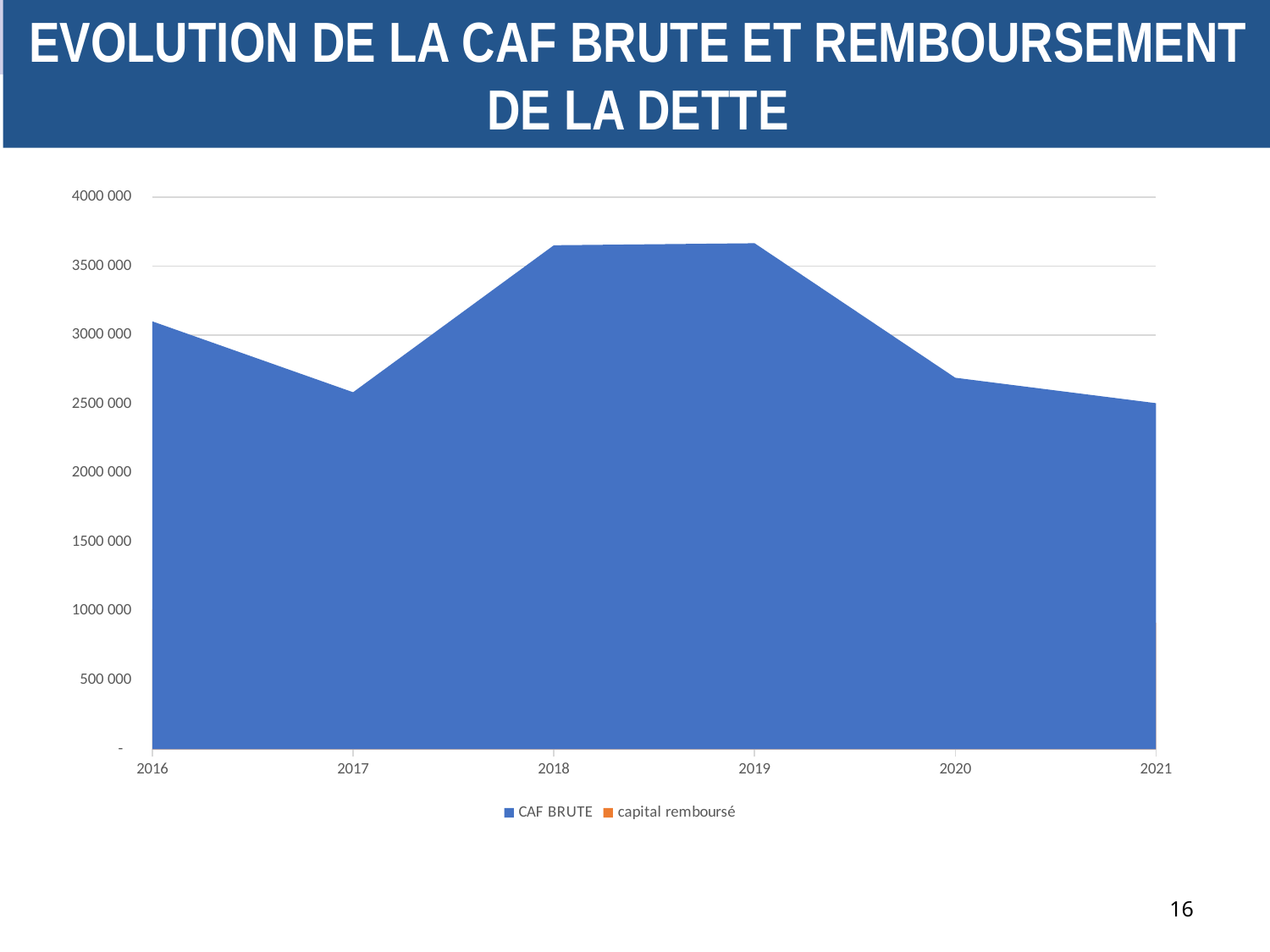
Is the CAF BRUTE value for 2020 greater or less than 3000 000? less Which two series are listed in the chart legend? CAF BRUTE and capital remboursé Which year has the larger CAF BRUTE value, 2017 or 2018? 2018 Does the CAF BRUTE value rise or fall from 2019 to 2021? fall Is the CAF BRUTE value for 2018 greater or less than 3500 000? greater How many series does the chart legend list? 2 What kind of chart is shown on the slide? area chart Which year has the larger CAF BRUTE value, 2016 or 2020? 2016 Is the CAF BRUTE value for 2016 greater or less than 3000 000? greater Does the CAF BRUTE value rise or fall from 2017 to 2018? rise How many years are shown on the x axis of the chart? 6